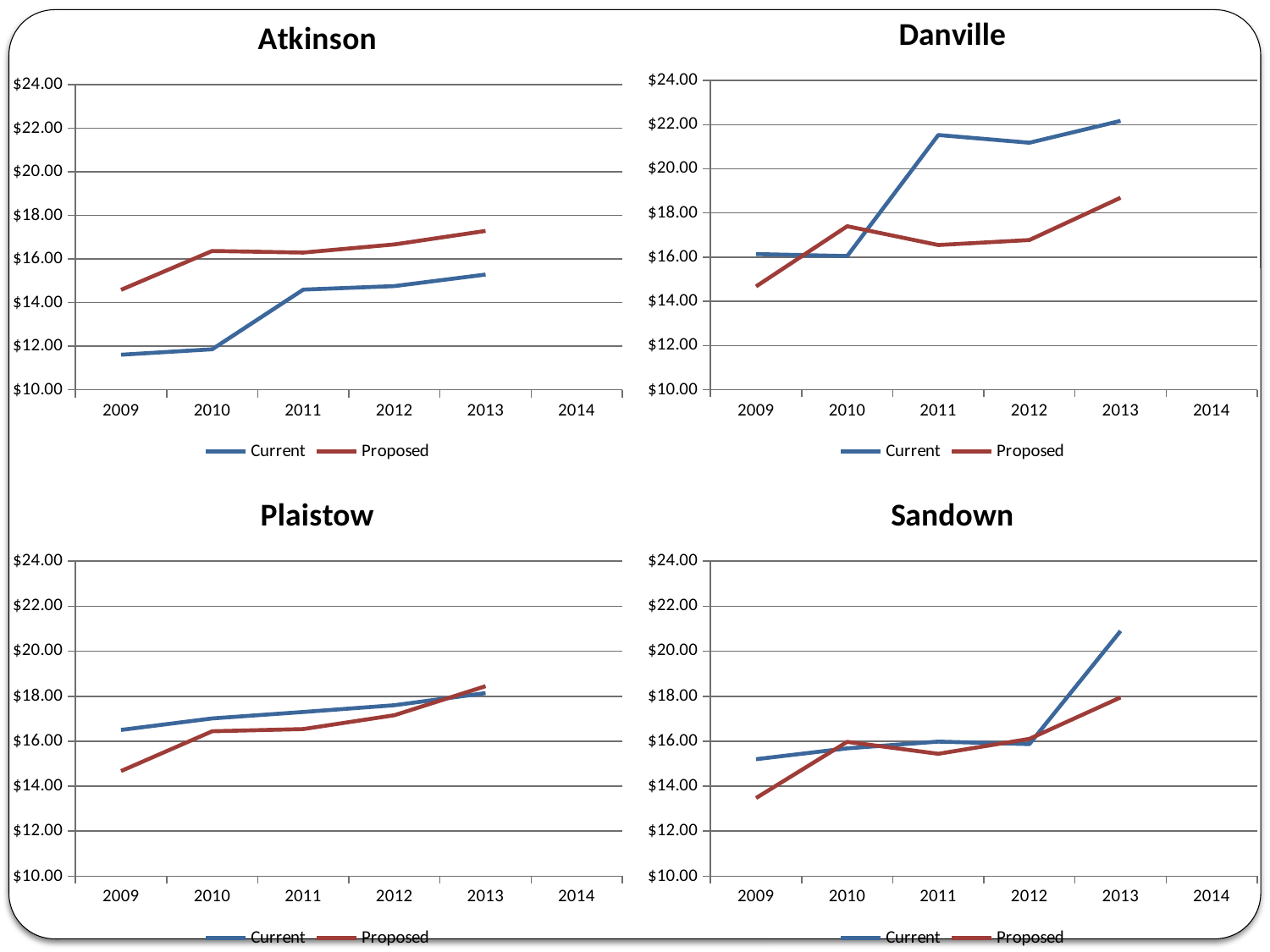
In the Danville chart, which series is higher in 2013, Current or Proposed? Current In the Danville chart, is the Current value for 2011 greater or less than $20.00? greater In the Atkinson chart, which series is higher in 2011, Current or Proposed? Proposed In the Atkinson chart, is the Current value for 2009 greater or less than $12.00? less What kind of chart is the Atkinson chart? line chart In the Plaistow chart, is the Proposed value for 2009 greater or less than $16.00? less In the Danville chart, which year has the lowest Proposed value? 2009 How many charts are shown on the slide? 4 In the Sandown chart, which year has the highest Current value? 2013 In the Plaistow chart, does the Current series rise or fall from 2009 to 2013? rise How many series does the legend of the Danville chart list? 2